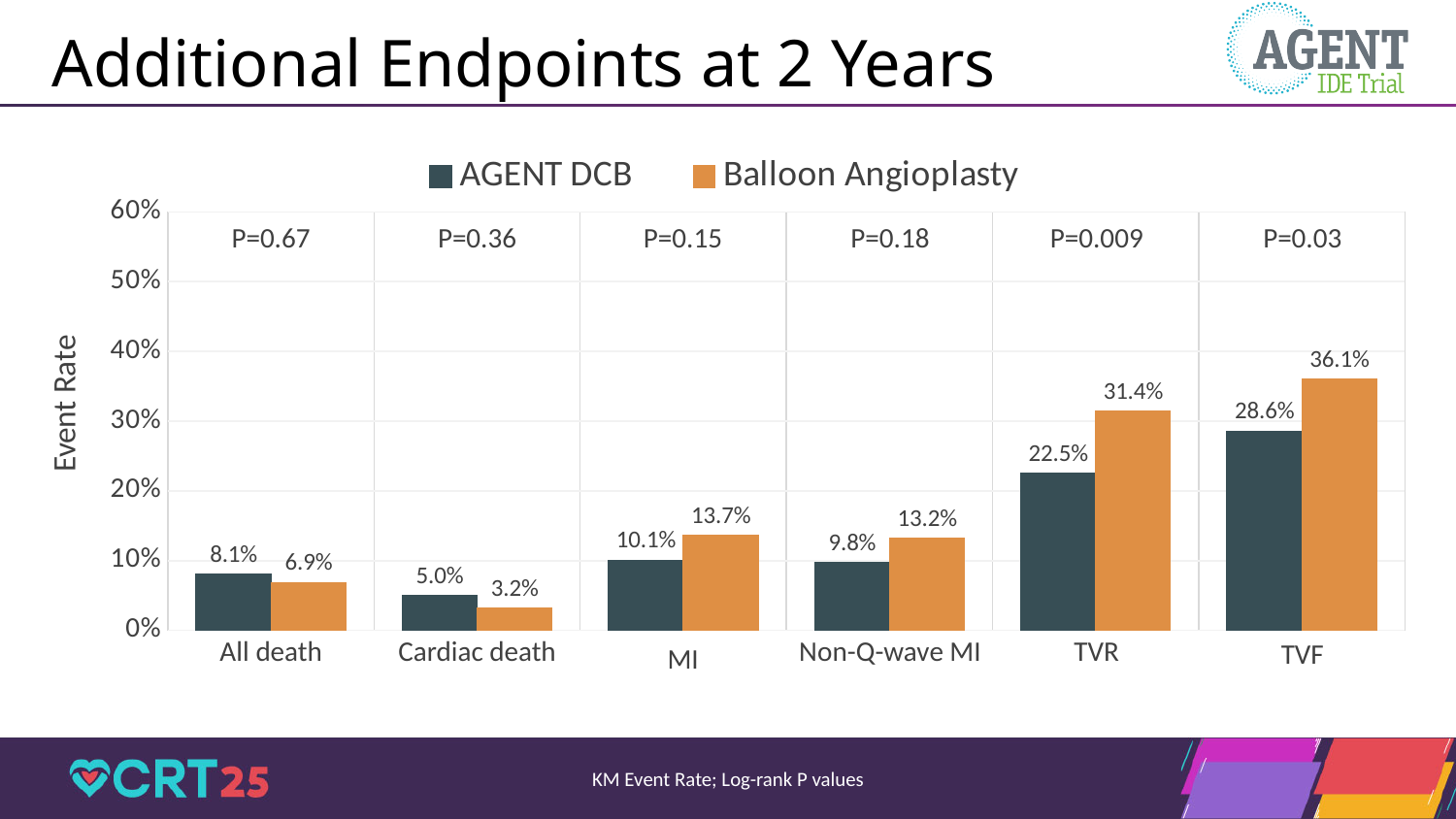
What is the AGENT DCB event rate for TVR? 22.5% How many series does the legend list? 2 How many endpoint categories are shown on the x axis? 6 Which endpoint has the lowest AGENT DCB event rate? Cardiac death What kind of chart is shown on the slide? Bar chart What is the Balloon Angioplasty event rate for TVF? 36.1% Which is larger for All death: the AGENT DCB rate or the Balloon Angioplasty rate? AGENT DCB What is the difference between the Balloon Angioplasty and AGENT DCB event rates for TVR? 8.9% What is the Balloon Angioplasty event rate for Cardiac death? 3.2% What P value is shown for TVR? P=0.009 Which endpoint has the highest Balloon Angioplasty event rate? TVF Is the Balloon Angioplasty event rate for TVR greater or less than 30%? greater